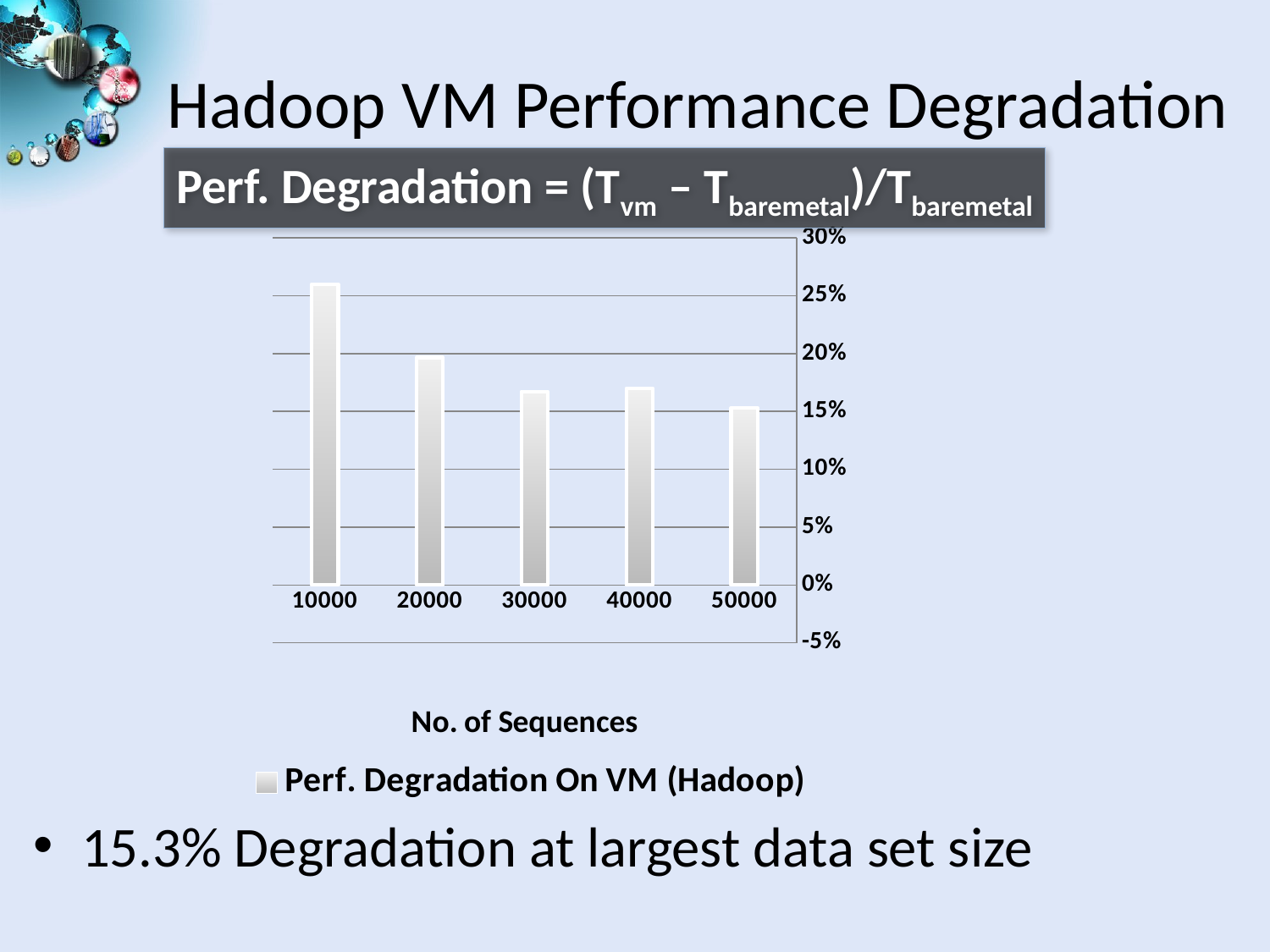
Which number of sequences has the lowest performance degradation? 50000 How many series does the legend list? 1 Do the performance degradation values generally rise or fall as the number of sequences increases? fall Which number of sequences has the highest performance degradation? 10000 How many categories (numbers of sequences) are plotted on the x axis? 5 What is the title of the x axis? No. of Sequences What series name is shown in the legend? Perf. Degradation On VM (Hadoop) What kind of chart is shown on the slide? bar chart Which has a larger performance degradation, 10000 sequences or 20000 sequences? 10000 Is the performance degradation for 10000 sequences greater or less than 25%? greater Is the performance degradation for 30000 sequences greater or less than 20%? less